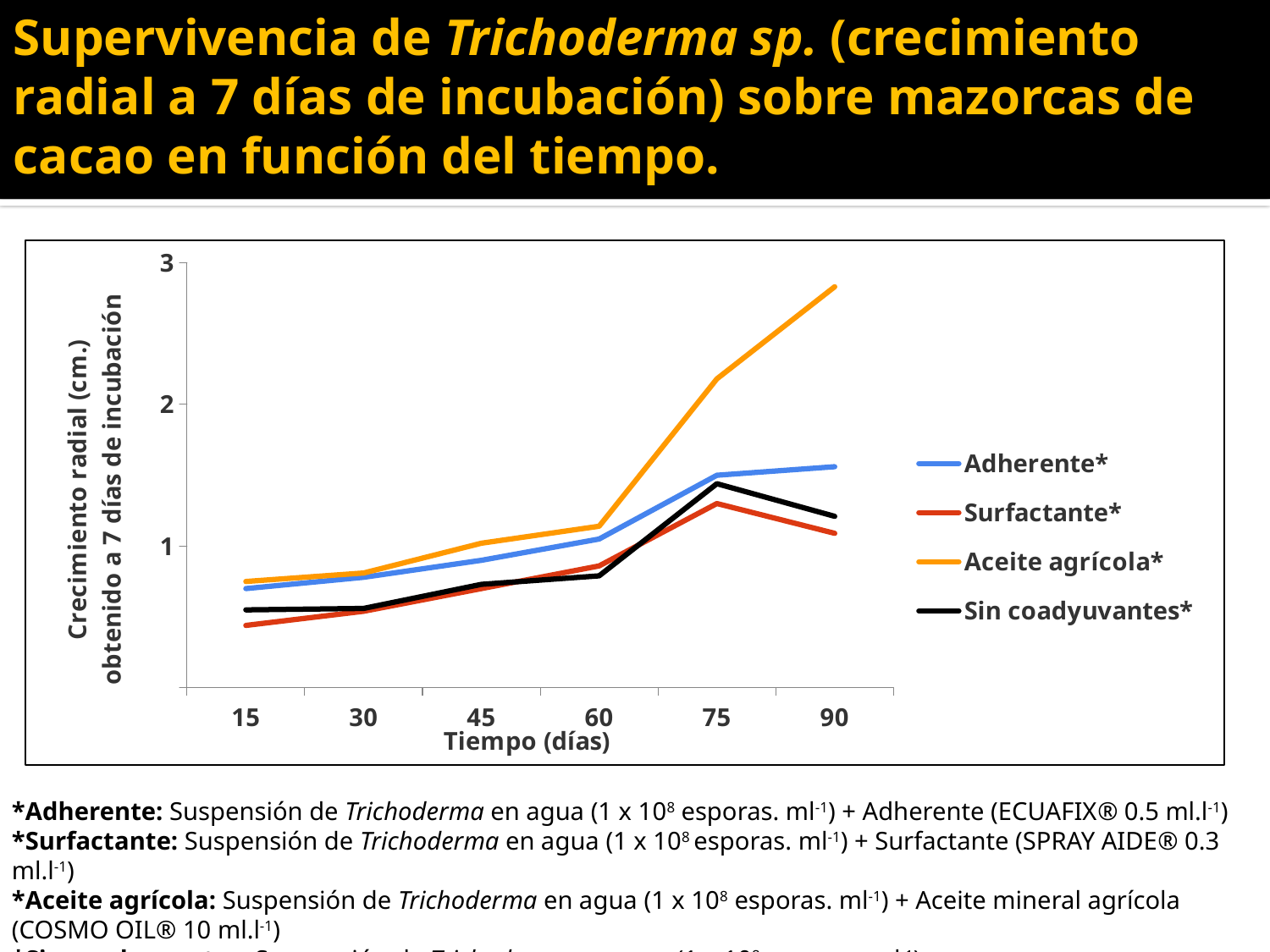
Which series has the lowest value at 15 days? Surfactante* What is the x-axis title of the chart? Tiempo (días) Does the Aceite agrícola* line rise or fall from 15 to 90 days? rise Is the value for Sin coadyuvantes* at 60 days greater or less than 1? less Is the value for Adherente* at 90 days greater or less than 2? less How many series does the legend list? 4 Is the value for Aceite agrícola* at 90 days greater or less than 2? greater Which series has the highest value at 90 days? Aceite agrícola* What kind of chart is shown on the slide? line chart How many time points are plotted along the x axis? 6 At 90 days, which is larger: Adherente* or Surfactante*? Adherente*